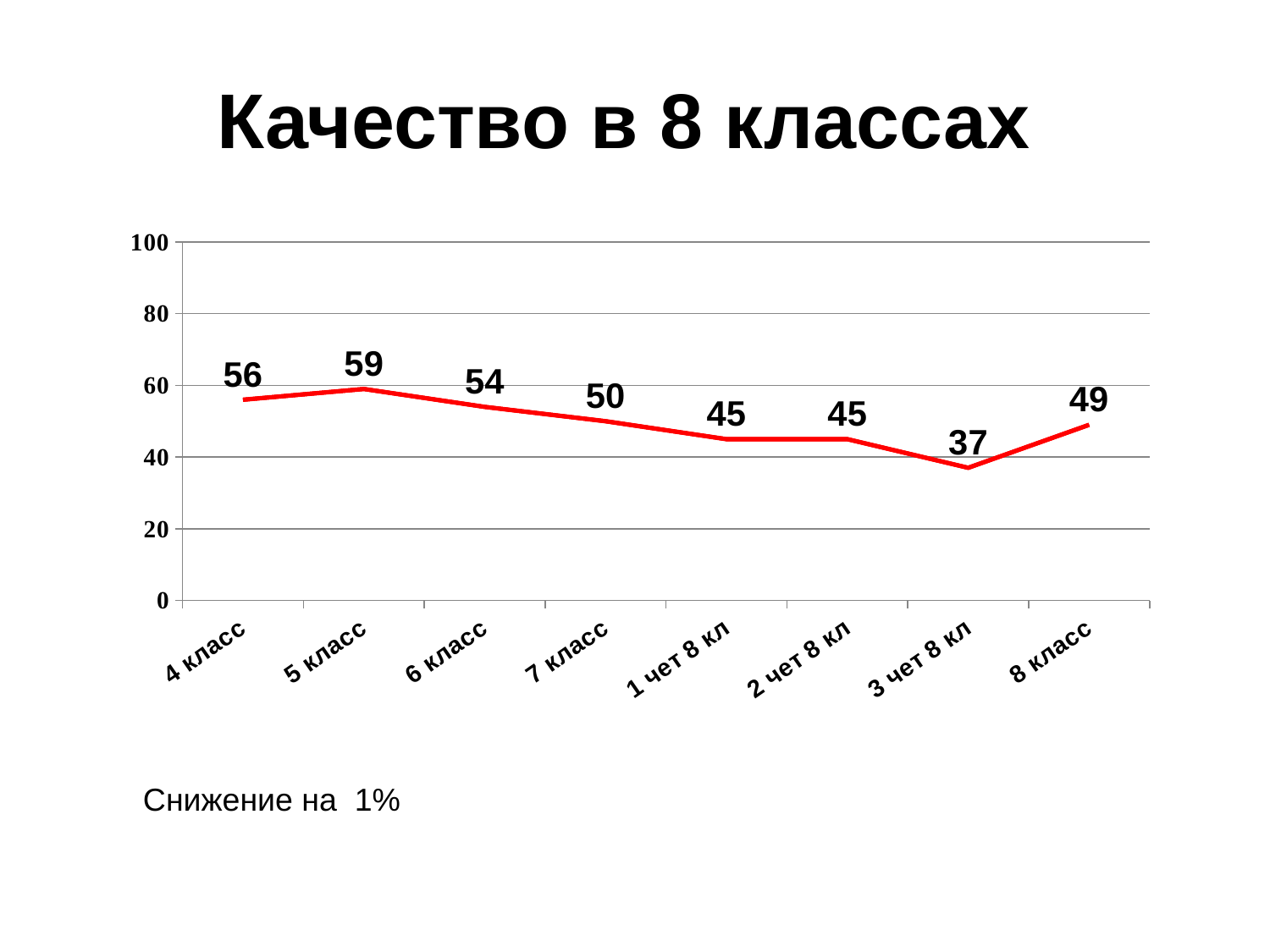
Is the value for 5 класс greater or less than 40? greater Which category has the highest value? 5 класс What is the difference between the values for 5 класс and 3 чет 8 кл? 22 How many data points are plotted on the chart? 8 Which category has the lowest value? 3 чет 8 кл What is the difference between the values for 7 класс and 8 класс? 1 What is the title of the slide? Качество в 8 классах Which is larger, the value for 6 класс or the value for 8 класс? 6 класс What is the value for 8 класс? 49 What kind of chart is shown on the slide? line chart What is the value for 3 чет 8 кл? 37 What is the value for 4 класс? 56